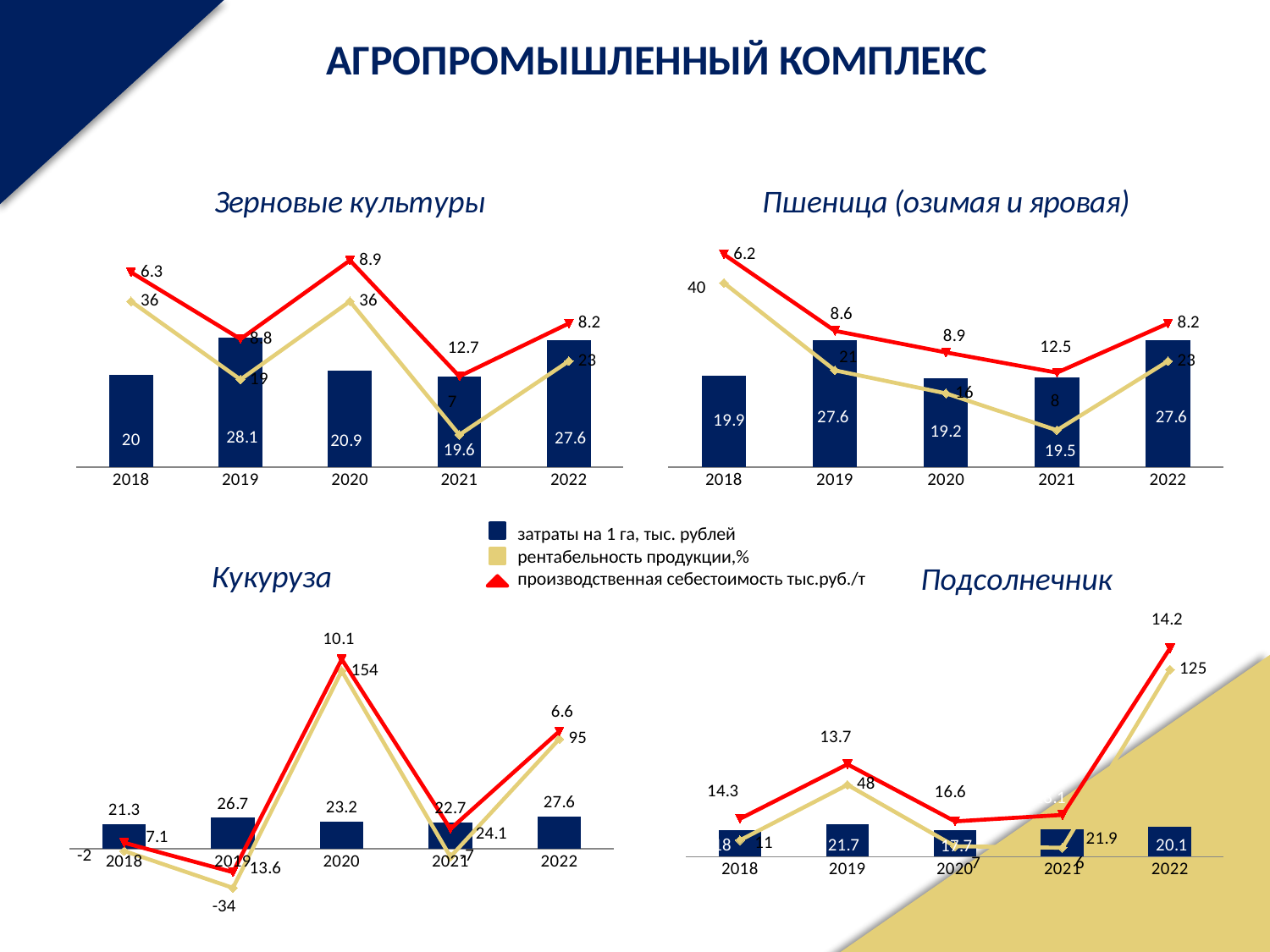
On the 'Зерновые культуры' chart, in which year is 'производственная себестоимость тыс.руб./т' highest? 2021 On the 'Кукуруза' chart, what is the 'производственная себестоимость тыс.руб./т' value for 2022? 6.6 On the 'Зерновые культуры' chart, what is the value of 'затраты на 1 га, тыс. рублей' for 2019? 28.1 On the 'Пшеница (озимая и яровая)' chart, what is the 'рентабельность продукции,%' value for 2018? 40 On the 'Зерновые культуры' chart, what is the 'рентабельность продукции,%' value for 2021? 7 On the 'Подсолнечник' chart, what is the 'рентабельность продукции,%' value for 2022? 125 On the 'Подсолнечник' chart, is 'затраты на 1 га' larger in 2019 or in 2020? 2019 On the 'Кукуруза' chart, which year has the lowest 'рентабельность продукции,%'? 2019 How many series does the shared legend list? 3 On the 'Кукуруза' chart, what is the 'рентабельность продукции,%' value for 2020? 154 On the 'Пшеница (озимая и яровая)' chart, in which year is 'затраты на 1 га, тыс. рублей' lowest? 2020 On the 'Пшеница (озимая и яровая)' chart, what is the difference between 'затраты на 1 га' in 2019 and 2018? 7.7